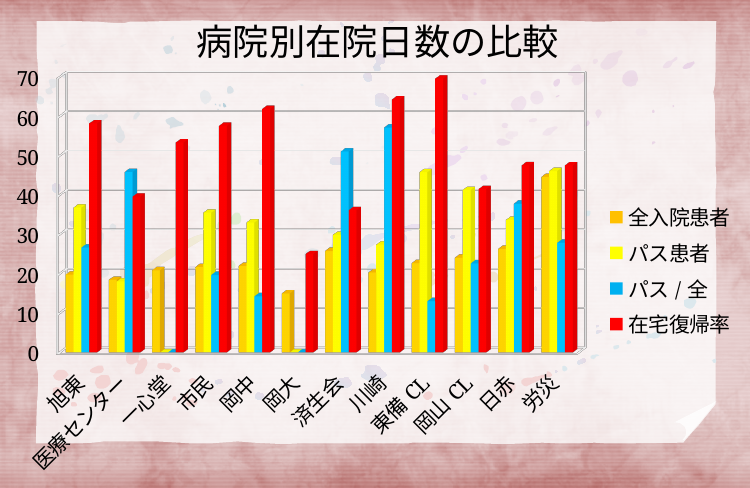
Which series is shown in red in the legend? 在宅復帰率 How many series does the legend list? 4 Which hospital has the lowest 在宅復帰率 value? 岡大 Which hospital has the highest 在宅復帰率 value? 東備 CL What is the title of the chart? 病院別在院日数の比較 Is the 在宅復帰率 value for 岡大 greater or less than 30? less Is the 在宅復帰率 value for 旭東 greater or less than 50? greater How many hospitals (categories) are shown on the x axis? 12 Which has the larger パス／全 value, 川崎 or 旭東? 川崎 Which hospital has the highest パス／全 value? 川崎 Is the パス／全 value for 東備 CL greater or less than 20? less What kind of chart is shown on the slide? bar chart